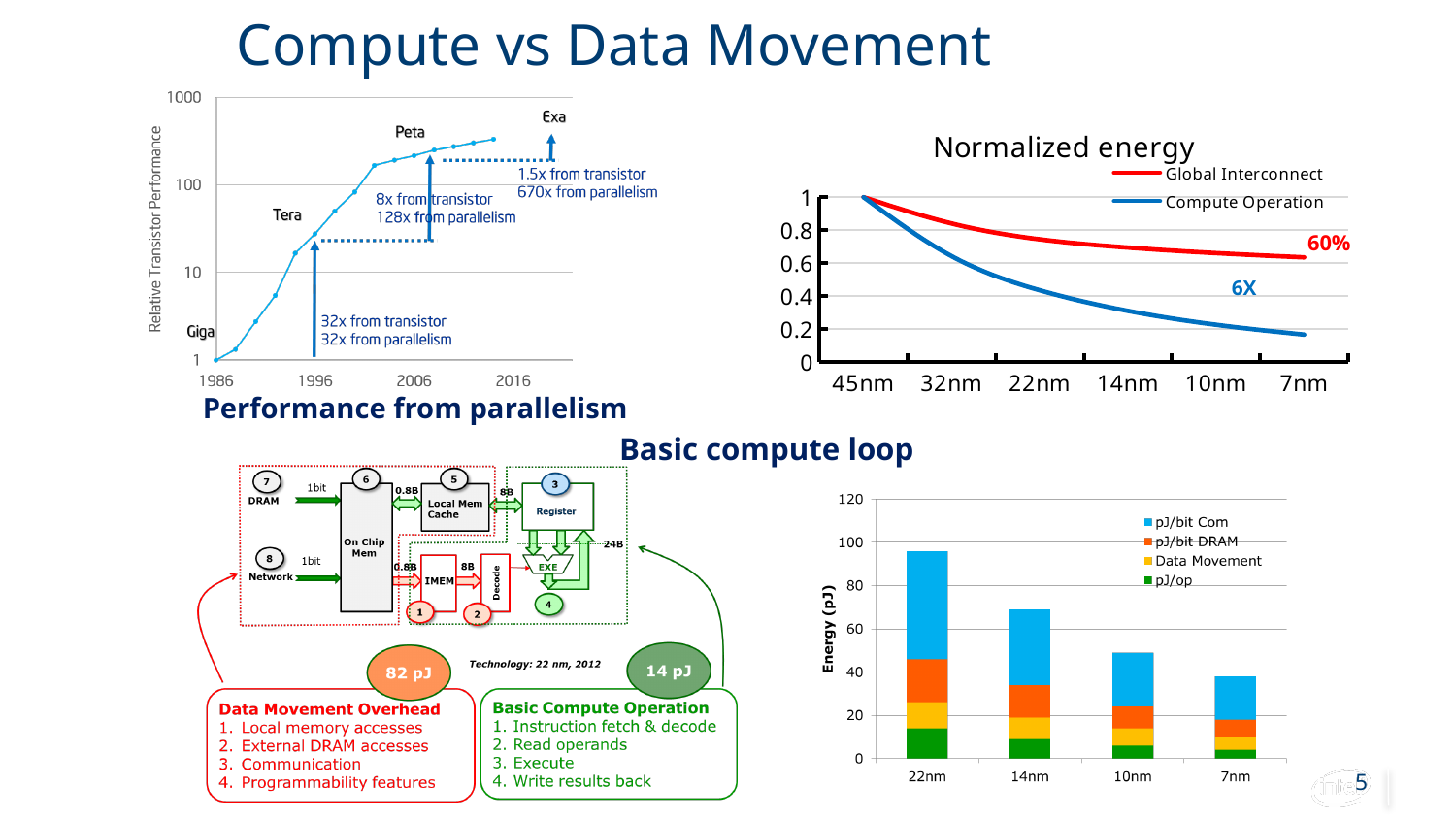
In the 'Normalized energy' chart, which series is drawn in red? Global Interconnect How many series does the legend of the 'Normalized energy' chart list? 2 In the 'Energy (pJ)' bar chart at the bottom right, is the total for 22nm greater or less than 80? greater What type of chart is the 'Relative Transistor Performance' chart at the top left of the slide? line chart How many process nodes are shown on the x axis of the 'Normalized energy' chart? 6 What type of chart is the 'Normalized energy' chart at the top right of the slide? line chart What type of chart is the 'Energy (pJ)' chart at the bottom right of the slide? stacked bar chart In the 'Normalized energy' chart, which series is higher at 7nm, Global Interconnect or Compute Operation? Global Interconnect In the 'Normalized energy' chart, do the values rise or fall from 45nm to 7nm? fall In the 'Energy (pJ)' bar chart at the bottom right, which process node has the highest total energy? 22nm How many series does the legend of the 'Energy (pJ)' bar chart at the bottom right list? 4 In the 'Normalized energy' chart, is the Compute Operation value at 7nm greater or less than 0.4? less